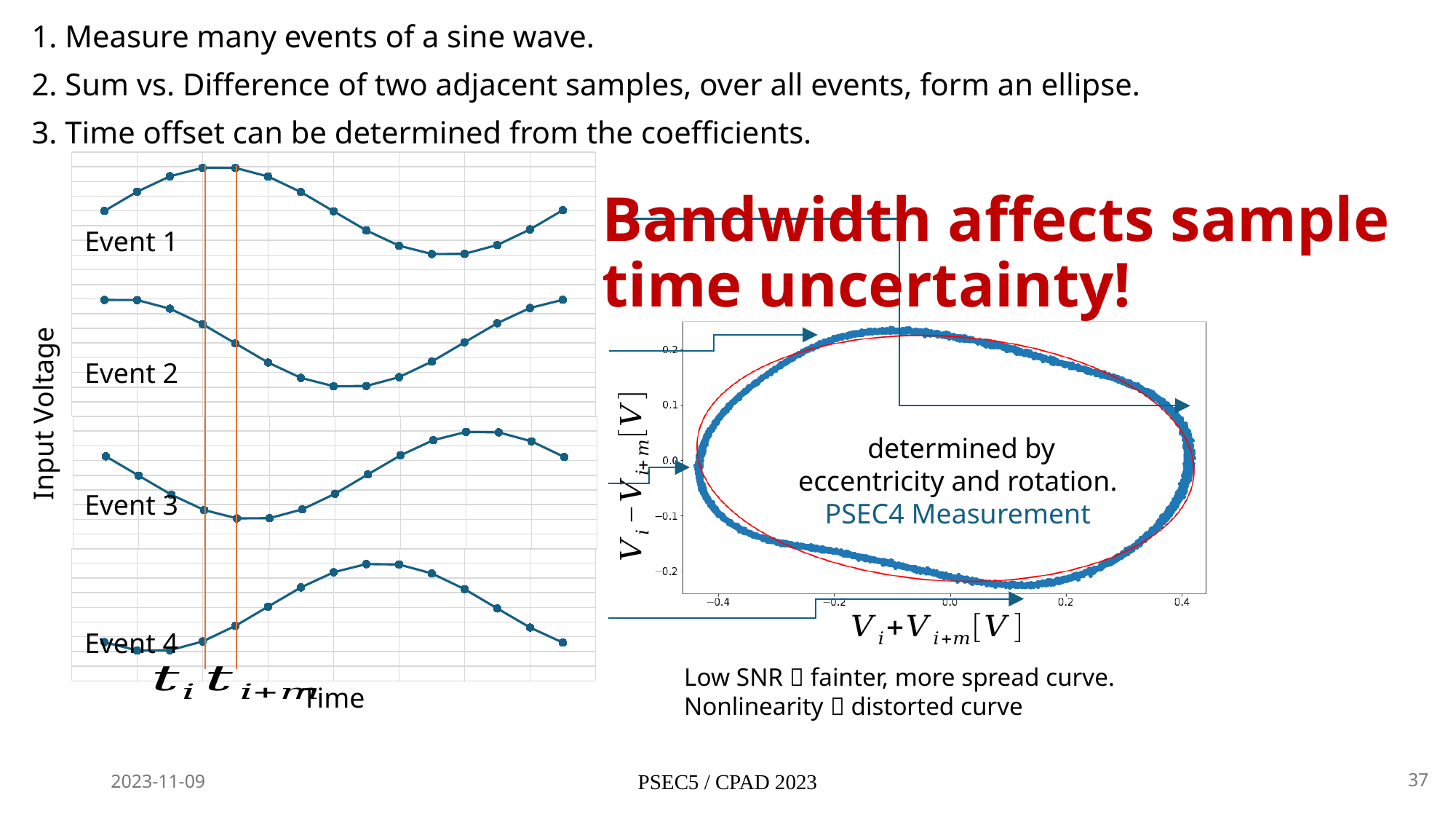
On the PSEC4 Measurement chart, what is the x-axis label? V_i + V_{i+m} [V] What kind of chart is the PSEC4 Measurement chart on the right? scatter chart On the PSEC4 Measurement chart, is the smallest value of V_i + V_{i+m} reached by the data greater or less than -0.4? less On the left chart, does Event 4 rise or fall between the vertical lines t_i and t_{i+m}? rise What is the x-axis label of the left chart? Time What kind of chart is the left chart showing Event 1 to Event 4? line chart On the left chart, does Event 2 rise or fall between the vertical lines t_i and t_{i+m}? fall How many events (series) are plotted on the left chart? 4 On the left chart, does Event 1 rise or fall between its first point and the vertical line at t_i? rise What is the y-axis label of the left chart? Input Voltage On the PSEC4 Measurement chart, is the lowest value of V_i - V_{i+m} reached by the data greater or less than -0.2? less On the PSEC4 Measurement chart, is the highest value of V_i - V_{i+m} reached by the data greater or less than 0.2? greater